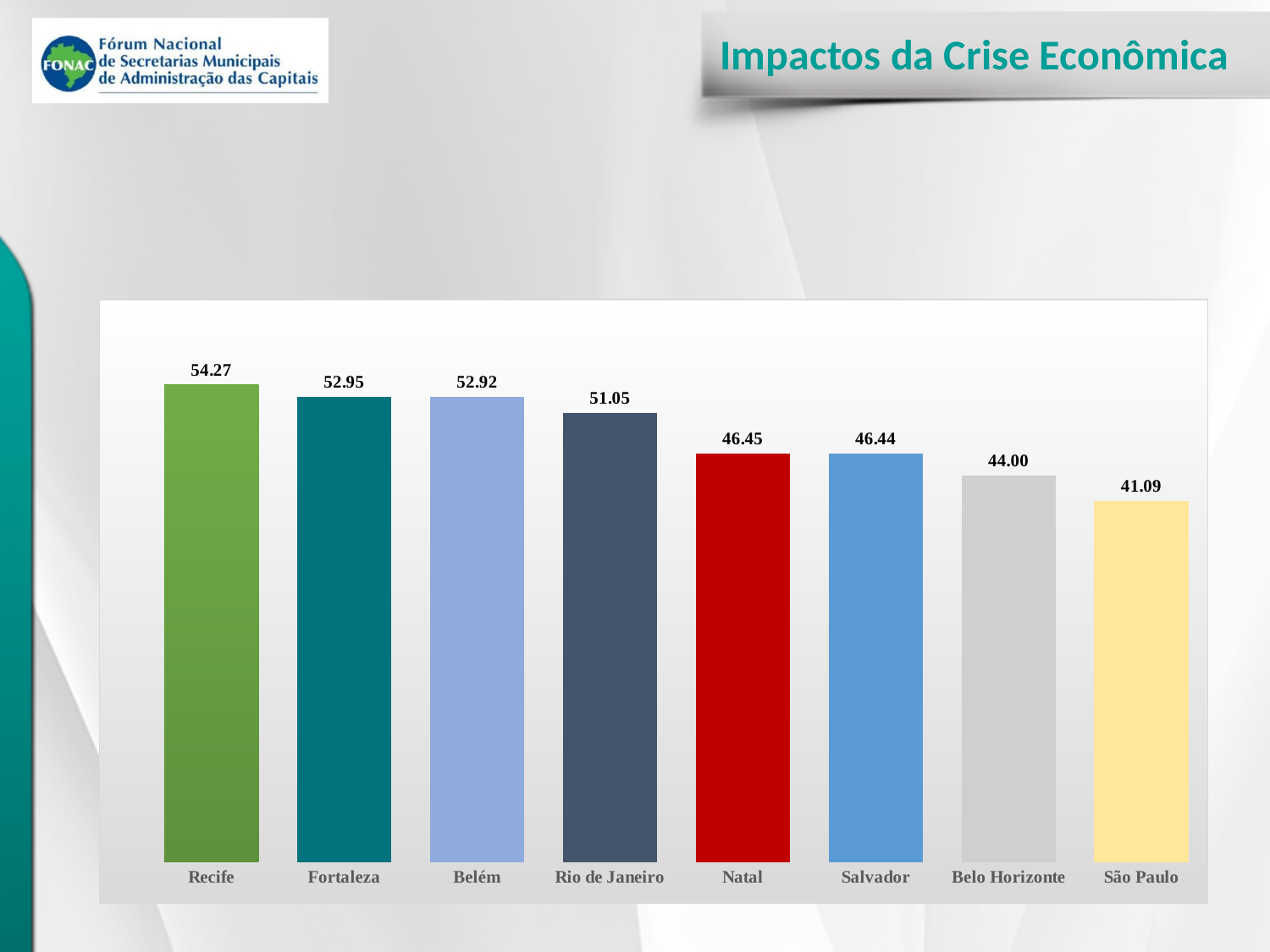
What is the value for Rio de Janeiro? 51.05 What is the difference between the values for Recife and São Paulo? 13.18 Do the values rise or fall from left to right across the cities? Fall What kind of chart is shown on the slide? Bar chart What is the difference between the values for Fortaleza and Belém? 0.03 Which has a larger value, Rio de Janeiro or Natal? Rio de Janeiro What is the value for Belo Horizonte? 44.00 Which city has the lowest value? São Paulo Which city has the highest value? Recife What is the value for Recife? 54.27 How many cities are shown in the chart? 8 What is the title of the slide containing the chart? Impactos da Crise Econômica